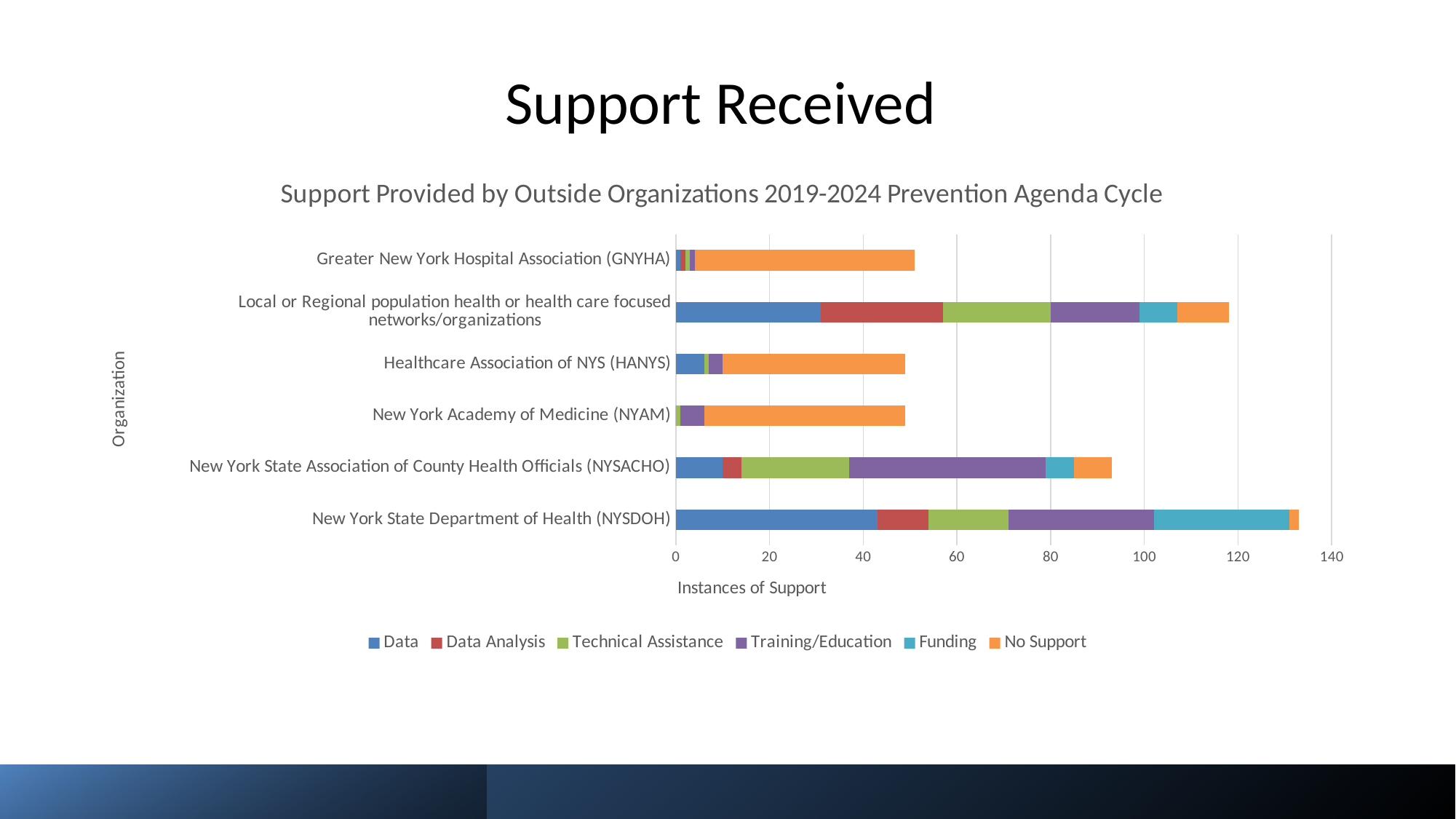
What is the label of the horizontal axis of the chart? Instances of Support Is the total bar for New York State Department of Health (NYSDOH) greater or less than 120? greater Is the total bar for Local or Regional population health or health care focused networks/organizations greater or less than 100? greater What is the title of the chart? Support Provided by Outside Organizations 2019-2024 Prevention Agenda Cycle Is the total bar for Healthcare Association of NYS (HANYS) greater or less than 60? less Which has a longer total bar: Greater New York Hospital Association (GNYHA) or Local or Regional population health or health care focused networks/organizations? Local or Regional population health or health care focused networks/organizations How many series does the chart legend list? 6 Which has a longer total bar: New York State Department of Health (NYSDOH) or New York State Association of County Health Officials (NYSACHO)? New York State Department of Health (NYSDOH) Which organization has the longest total bar in the chart? New York State Department of Health (NYSDOH) How many organizations are listed on the vertical axis of the chart? 6 What kind of chart is shown on the slide? bar chart